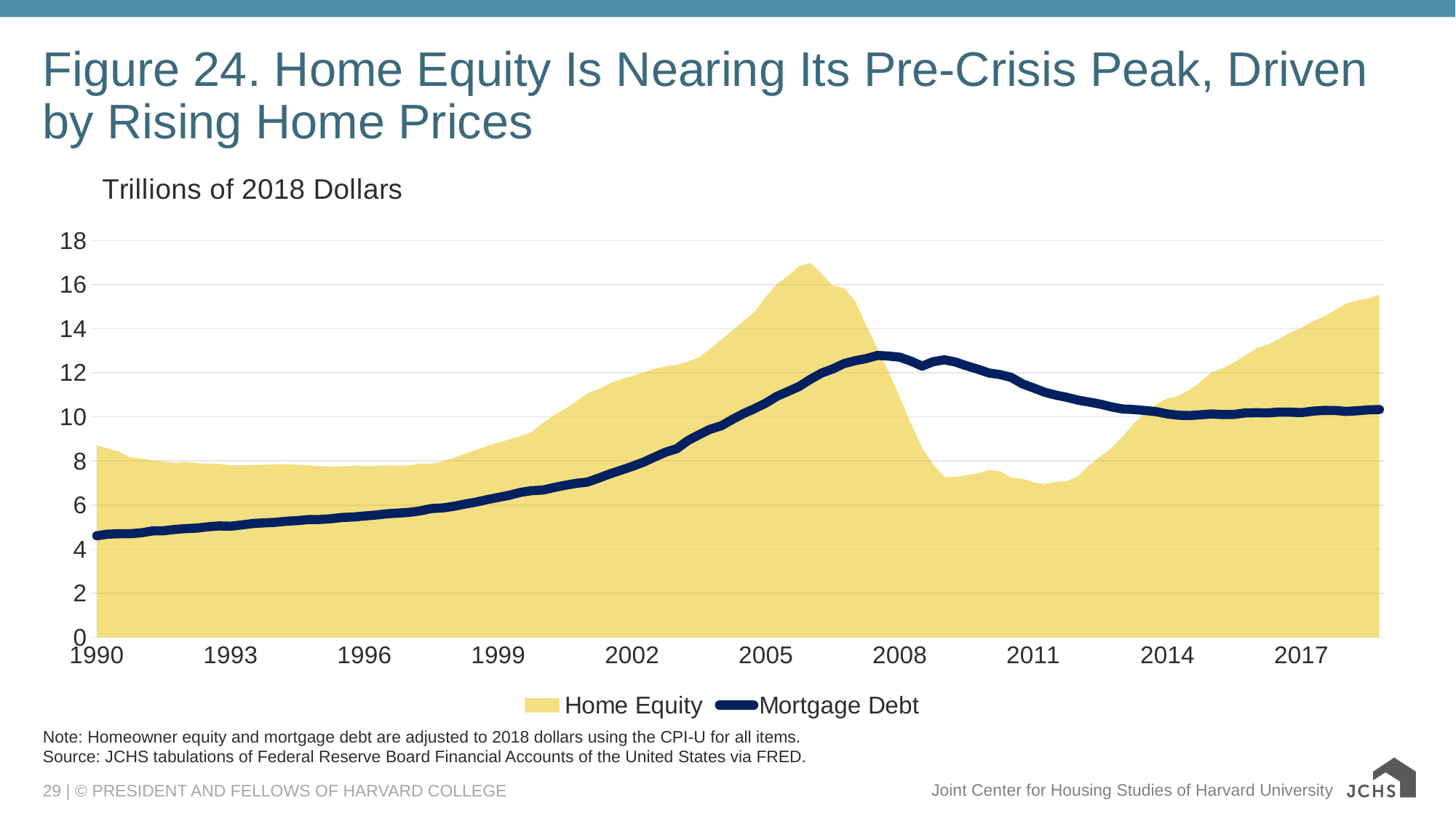
Is the value for Home Equity in 1990 greater or less than 8? greater Is the value for Home Equity in 2011 greater or less than 8? less What kind of chart is this? Area chart with a line series Which series reaches the higher peak value on the chart? Home Equity In 2005, which is larger, Home Equity or Mortgage Debt? Home Equity How many series does the legend list? 2 Is the value for Mortgage Debt in 1990 greater or less than 6? less What unit is shown above the chart for the values? Trillions of 2018 Dollars Does Mortgage Debt rise or fall between 1990 and 2008? rise Which series is drawn as a dark blue line? Mortgage Debt In 2011, which is larger, Home Equity or Mortgage Debt? Mortgage Debt